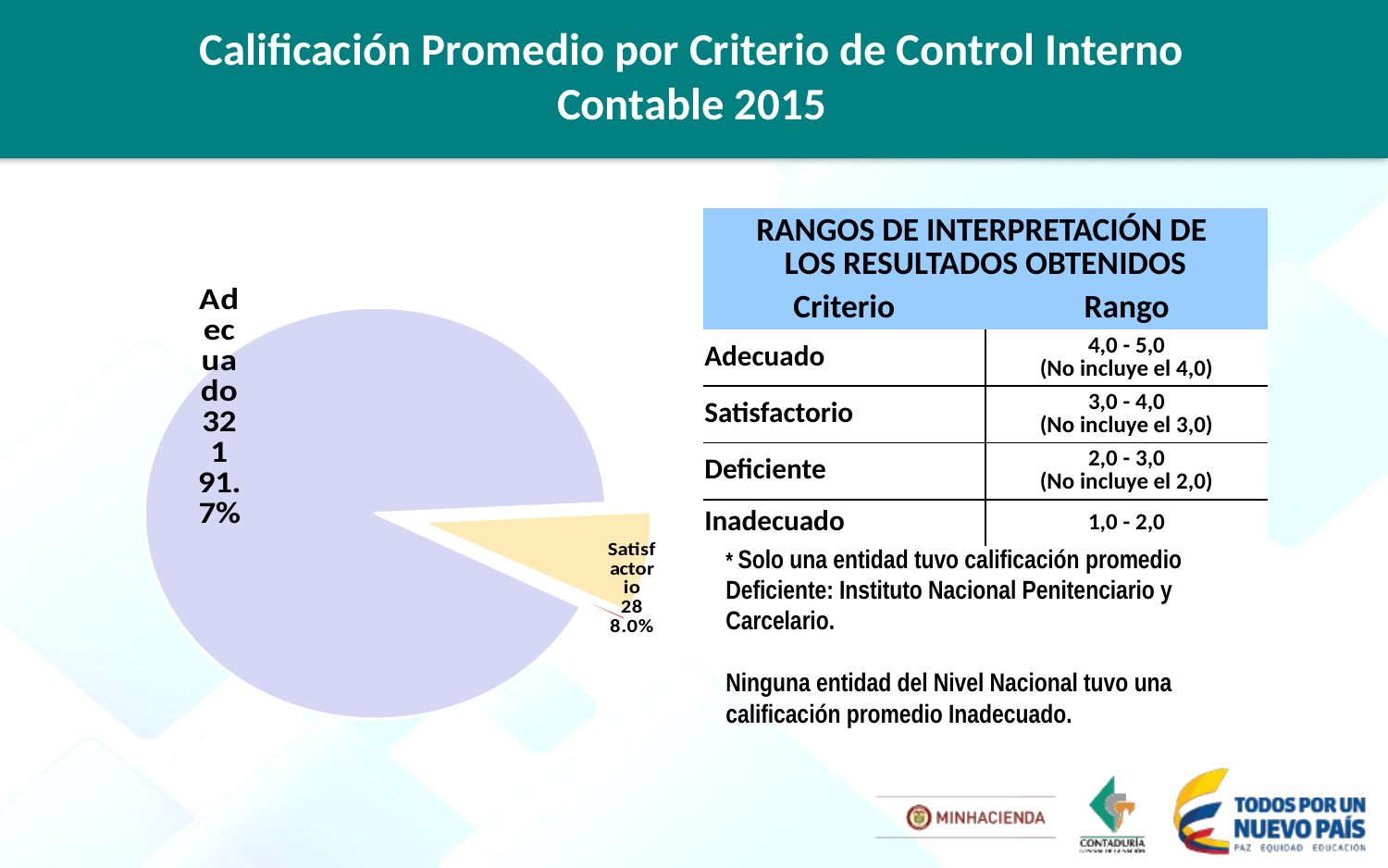
What is the title of the slide containing the pie chart? Calificación Promedio por Criterio de Control Interno Contable 2015 Which labeled slice of the pie chart is the largest? Adecuado What type of chart is shown on the slide? pie chart How many entities are in the Satisfactorio slice of the pie chart? 28 Which is larger in the pie chart, Adecuado or Satisfactorio? Adecuado What colour is the Adecuado slice of the pie chart? light purple How many entities are in the Adecuado slice of the pie chart? 321 What percentage of the pie does the Adecuado slice represent? 91.7% What percentage of the pie does the Satisfactorio slice represent? 8.0% What is the difference between the number of entities in the Adecuado slice and the Satisfactorio slice? 293